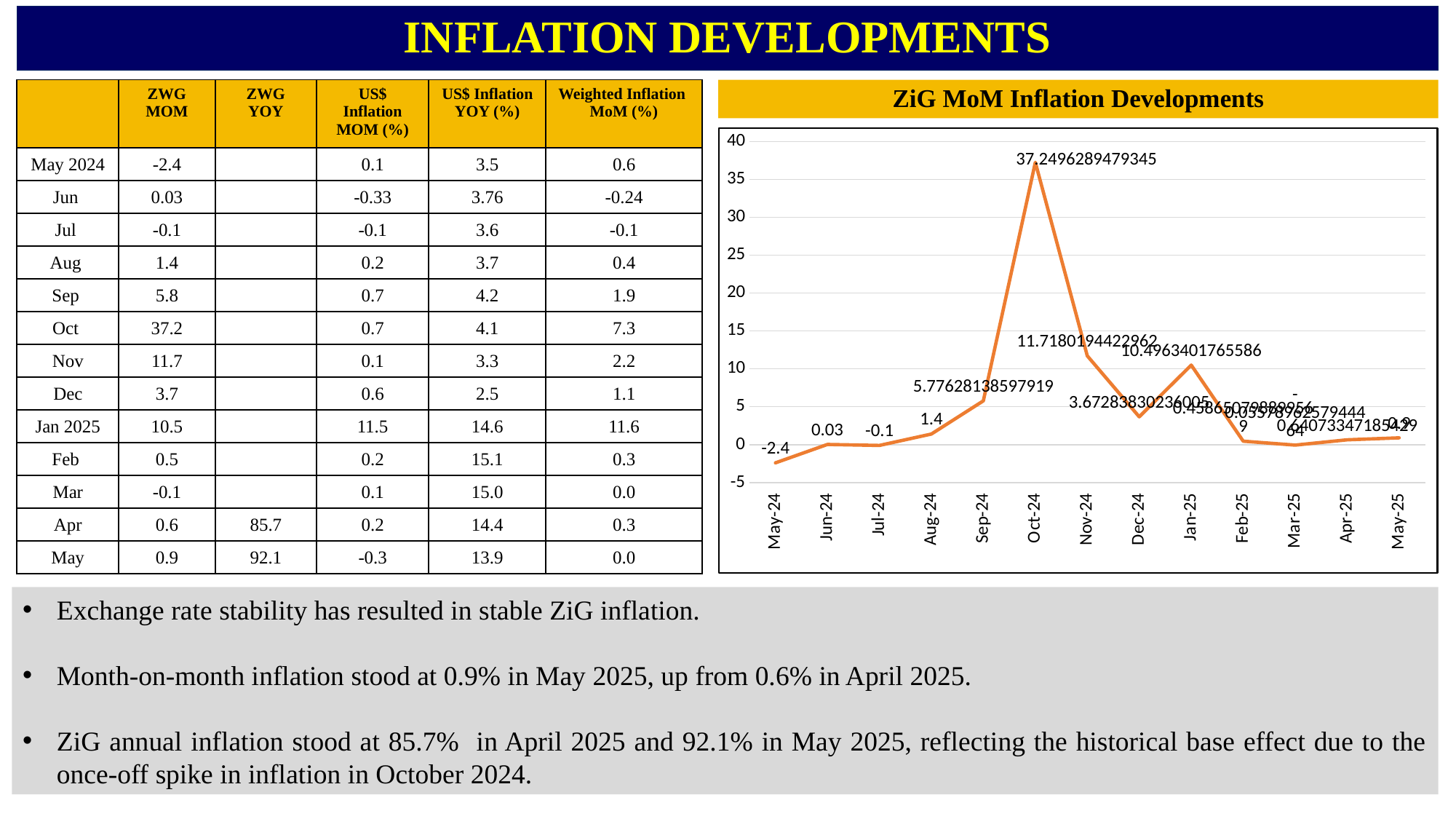
In the ZiG MoM Inflation Developments chart, is the value for Sep-24 greater or less than 5? greater What is the data label for Oct-24 in the ZiG MoM Inflation Developments chart? 37.2496289479345 What kind of chart is the ZiG MoM Inflation Developments chart? line chart In the ZiG MoM Inflation Developments chart, what is the difference between the values for Aug-24 and May-24? 3.8 What is the data label for Nov-24 in the ZiG MoM Inflation Developments chart? 11.7180194422962 What is the value for Jun-24 in the ZiG MoM Inflation Developments chart? 0.03 In the ZiG MoM Inflation Developments chart, which is larger, the value for Nov-24 or the value for Jan-25? Nov-24 How many months are plotted on the x axis of the ZiG MoM Inflation Developments chart? 13 Which month has the highest value in the ZiG MoM Inflation Developments chart? Oct-24 What is the value for May-24 in the ZiG MoM Inflation Developments chart? -2.4 Which month has the lowest value in the ZiG MoM Inflation Developments chart? May-24 What is the value for Aug-24 in the ZiG MoM Inflation Developments chart? 1.4